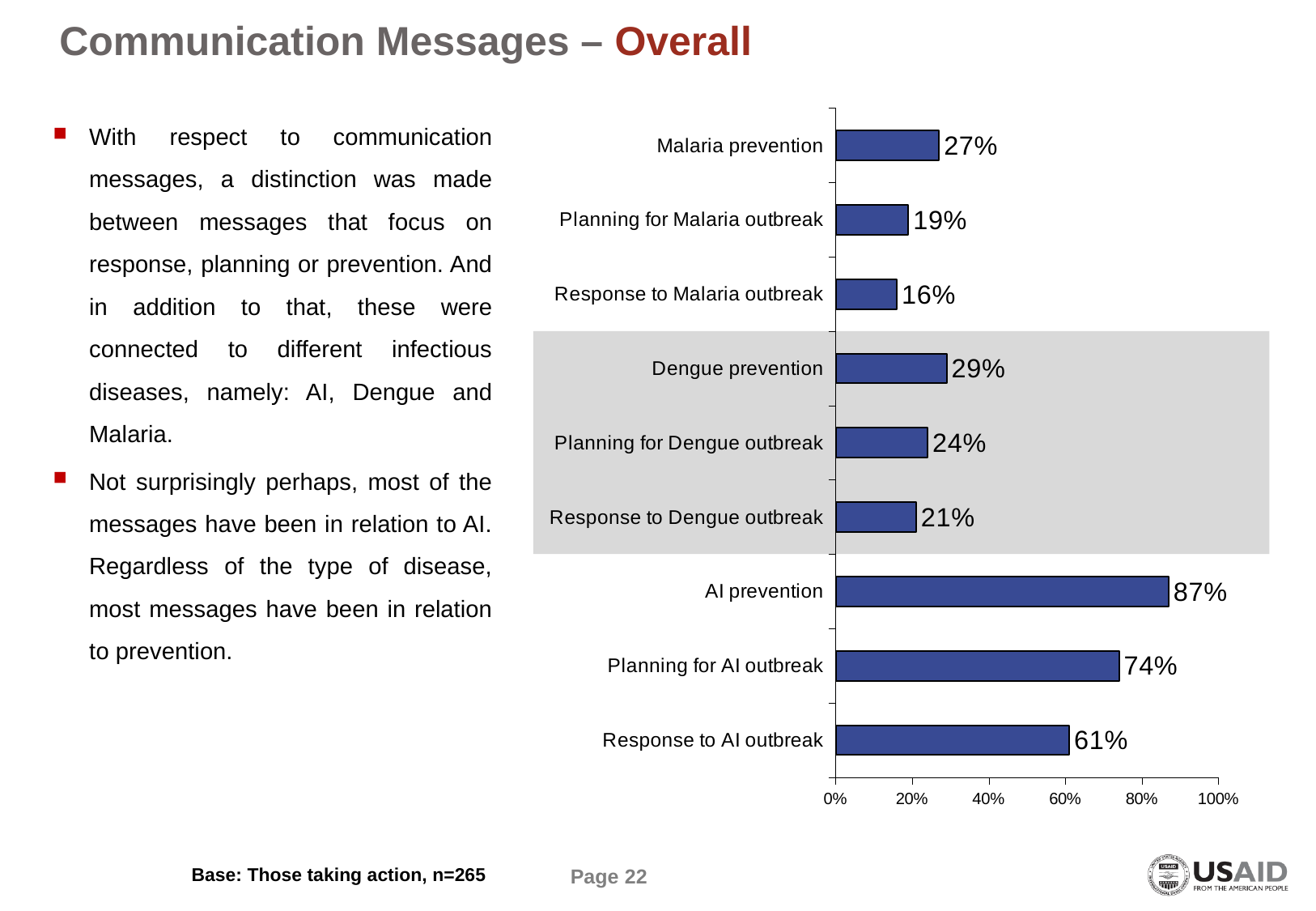
Which category has the lowest value? Response to Malaria outbreak What is the maximum value shown on the x axis? 100% What is the value for Response to Malaria outbreak? 16% Is the value for Planning for AI outbreak greater or less than 60%? greater Which is larger, Response to AI outbreak or Response to Dengue outbreak? Response to AI outbreak What is the difference between Dengue prevention and Malaria prevention? 2% What is the difference between AI prevention and Planning for AI outbreak? 13% What is the value for Planning for Dengue outbreak? 24% Which category has the highest value? AI prevention What is the value for AI prevention? 87% How many categories are shown in the chart? 9 What kind of chart is shown on the slide? Bar chart